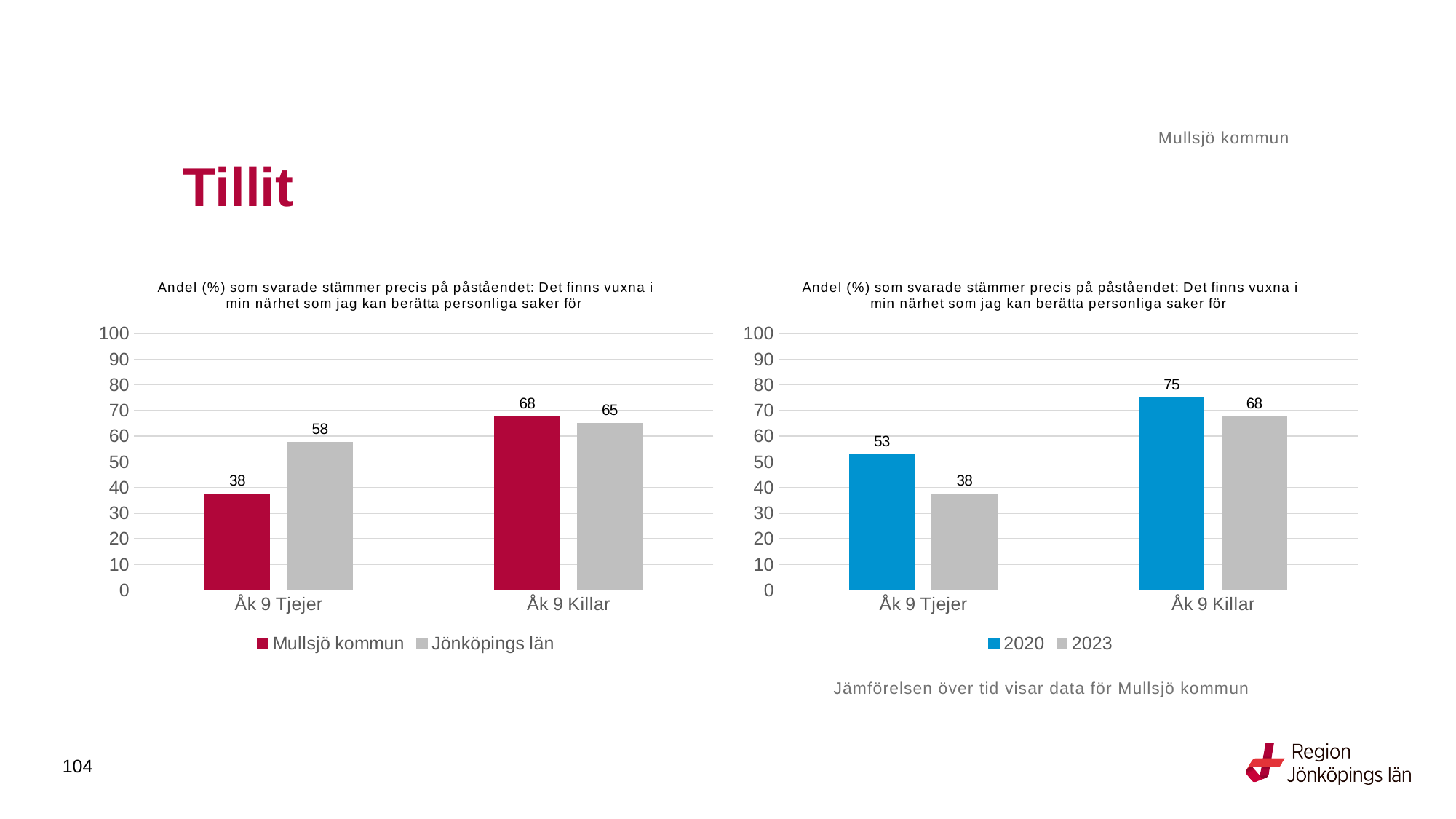
How many series does the legend of the right chart list? 2 In the left chart, what is the difference between Jönköpings län and Mullsjö kommun for Åk 9 Tjejer? 20 In the right chart, what is the difference between 2020 and 2023 for Åk 9 Tjejer? 15 In the left chart, what is the value for Mullsjö kommun for Åk 9 Tjejer? 38 In the right chart, what is the value for 2023 for Åk 9 Tjejer? 38 What kind of chart is the left chart? Bar chart In the left chart, what is the value for Jönköpings län for Åk 9 Killar? 65 In the right chart, which category has the lowest value for 2023? Åk 9 Tjejer In the right chart, which category has the highest value for 2020? Åk 9 Killar In the right chart, what is the value for 2020 for Åk 9 Killar? 75 What are the two series listed in the legend of the left chart? Mullsjö kommun and Jönköpings län In the left chart, which is larger for Åk 9 Killar: Mullsjö kommun or Jönköpings län? Mullsjö kommun